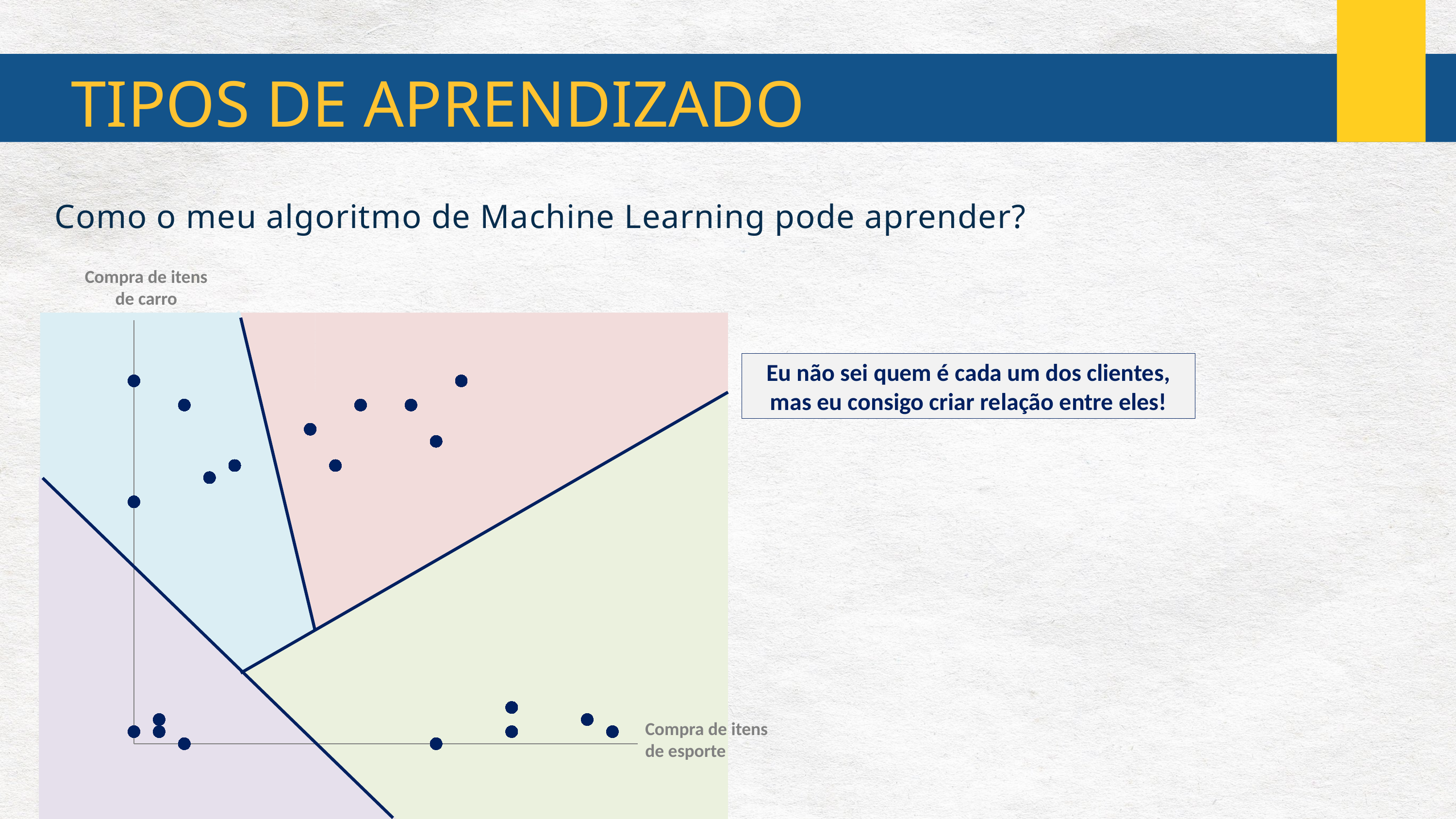
What is the label of the horizontal axis of the chart? Compra de itens de esporte What is the label of the vertical axis of the chart? Compra de itens de carro What kind of chart is shown on the slide? scatter plot How many data points are plotted in the purple region at the bottom left of the chart? 4 How many data points are plotted in total on the chart? 20 Which coloured region of the chart contains the fewest data points? purple How many data points are plotted in the green region of the chart? 5 Which coloured region of the chart contains the most data points? pink